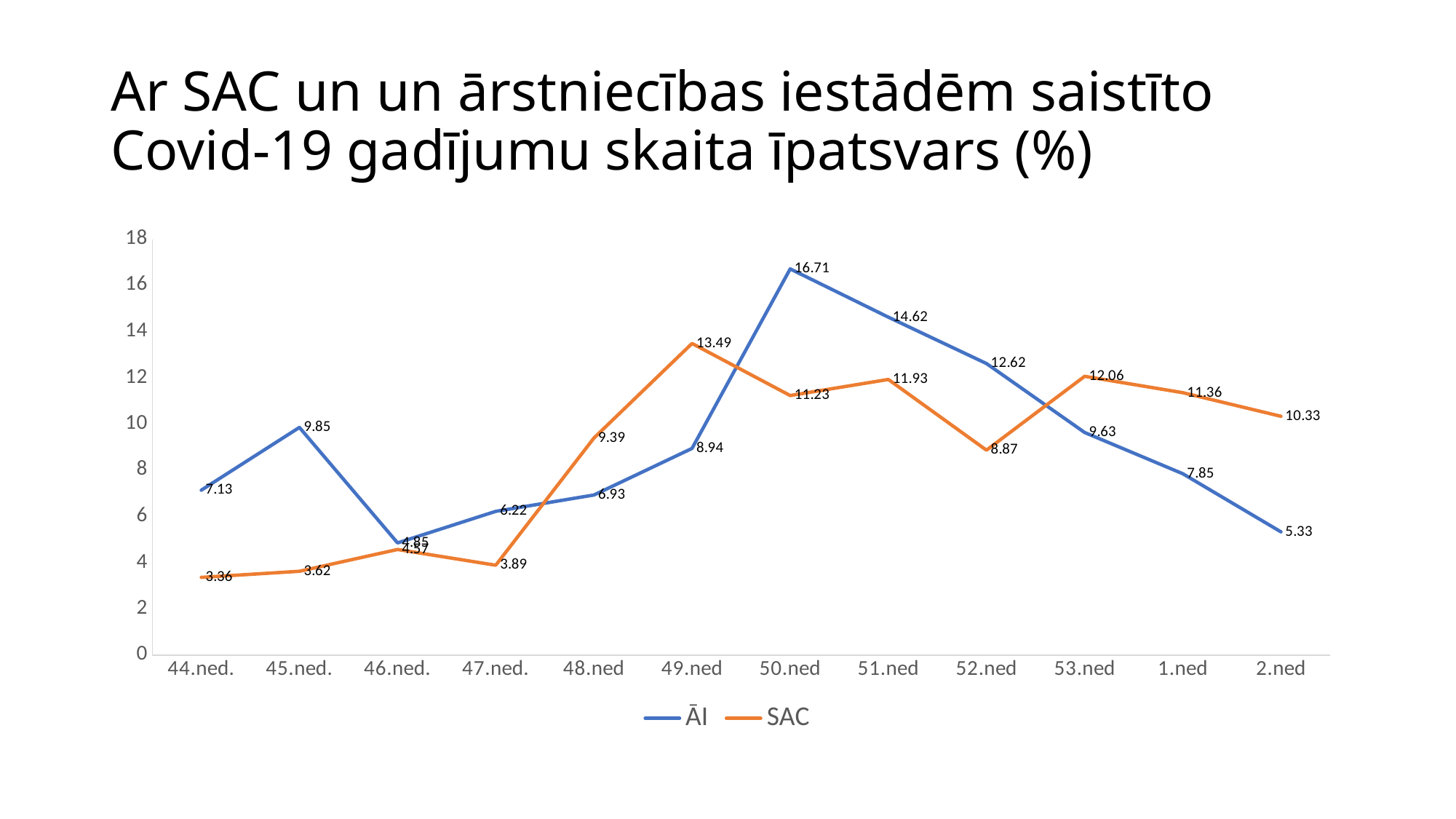
In which week does the ĀI series reach its highest value? 50.ned How many series does the legend list? 2 Does the ĀI series rise or fall from 50.ned to 2.ned? fall In which week does the SAC series have its lowest value? 44.ned. What is the SAC value for 2.ned? 10.33 At 53.ned, which series has the larger value, ĀI or SAC? SAC What is the SAC value for 49.ned? 13.49 What kind of chart is shown on the slide? line chart Is the SAC value for 47.ned. greater or less than 6? less What is the difference between the ĀI and SAC values at 50.ned? 5.48 What is the ĀI value for 50.ned? 16.71 How many weeks are plotted on the x axis? 12